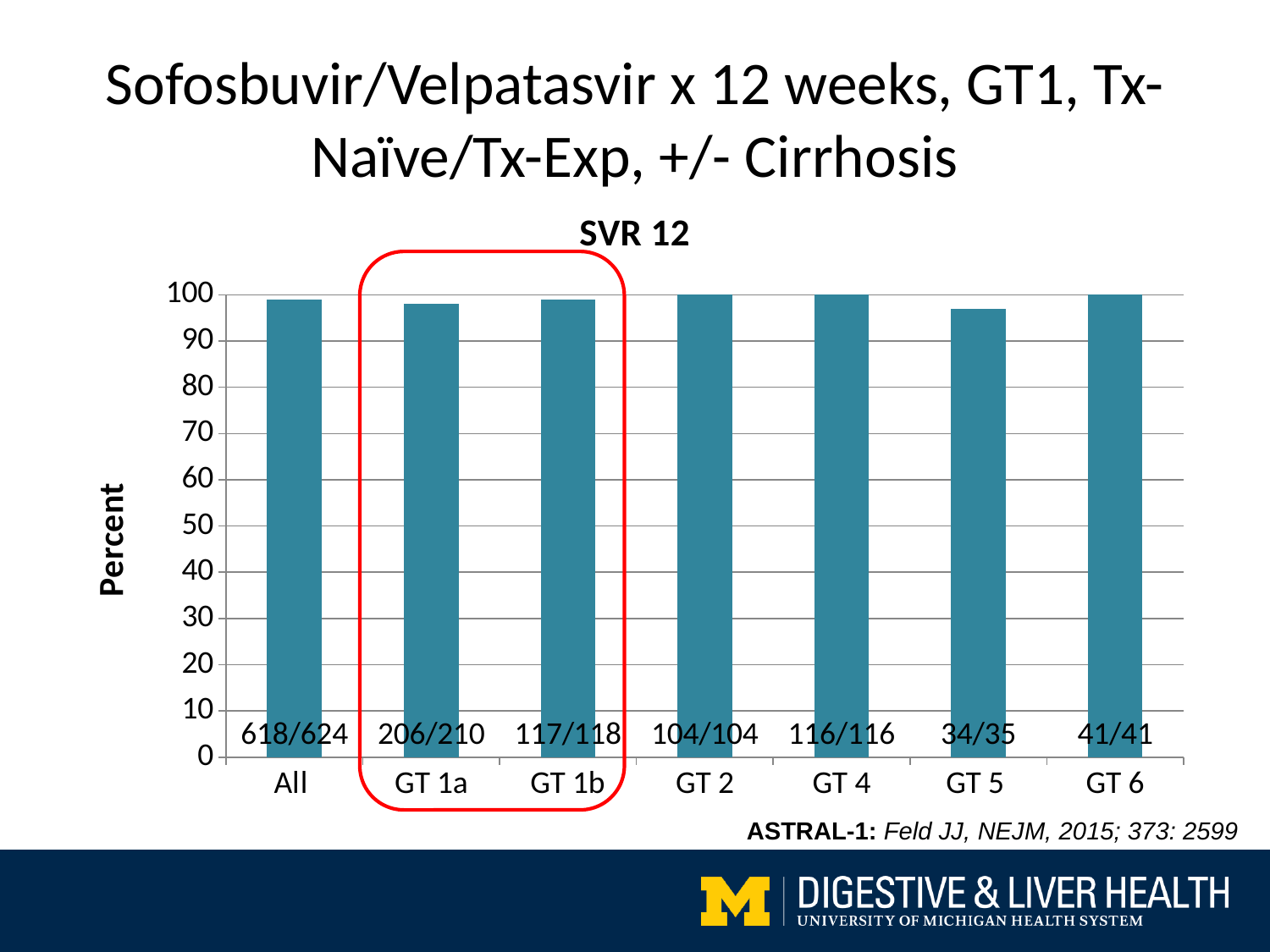
Is the value for GT 1a greater or less than 80? greater How many categories are shown on the x axis of the chart? 7 What is the label printed on the bar for GT 5? 34/35 Which two categories are enclosed by the red outline on the chart? GT 1a and GT 1b What is the label printed on the bar for GT 6? 41/41 What is the label printed on the bar for GT 2? 104/104 What is the title of the chart? SVR 12 What is the label printed on the bar for the All category? 618/624 Is the value for GT 5 greater or less than 90? greater What is the label printed on the bar for GT 1b? 117/118 What kind of chart is shown on the slide? Bar chart What is the label printed on the bar for GT 1a? 206/210